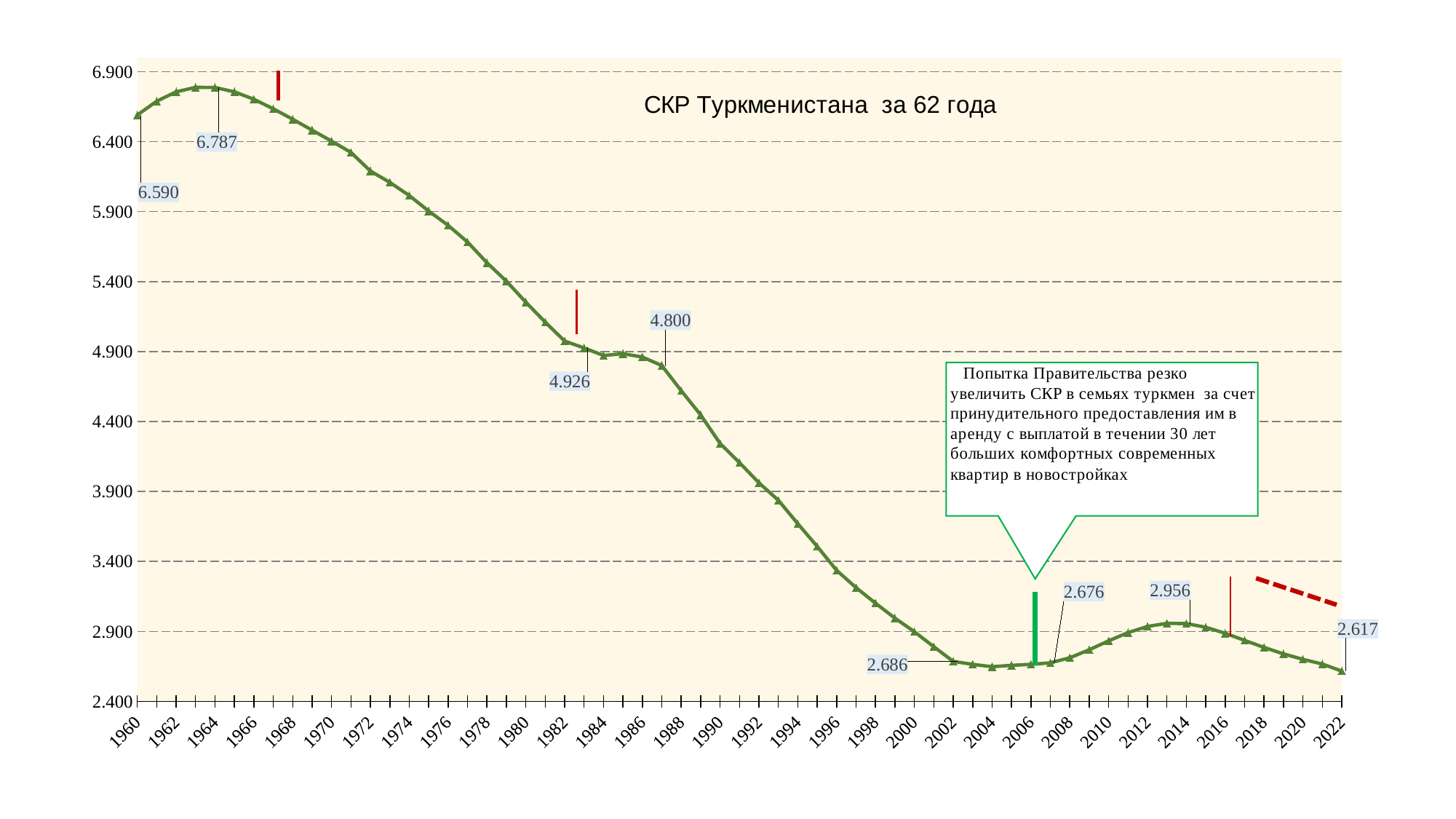
By how much did the value fall from 1960 to 2022? 3.973 Which is larger, the value for 1982 or the value for 1987? 1982 What kind of chart is shown on the slide? line chart What is the value for 2022? 2.617 What is the difference between the values for 1964 and 1960? 0.197 Is the value for 1990 greater or less than 4.400? less What is the value for 1960? 6.590 Overall, do the values rise or fall from 1960 to 2022? fall What is the title of the chart? СКР Туркменистана за 62 года What is the value for 1964? 6.787